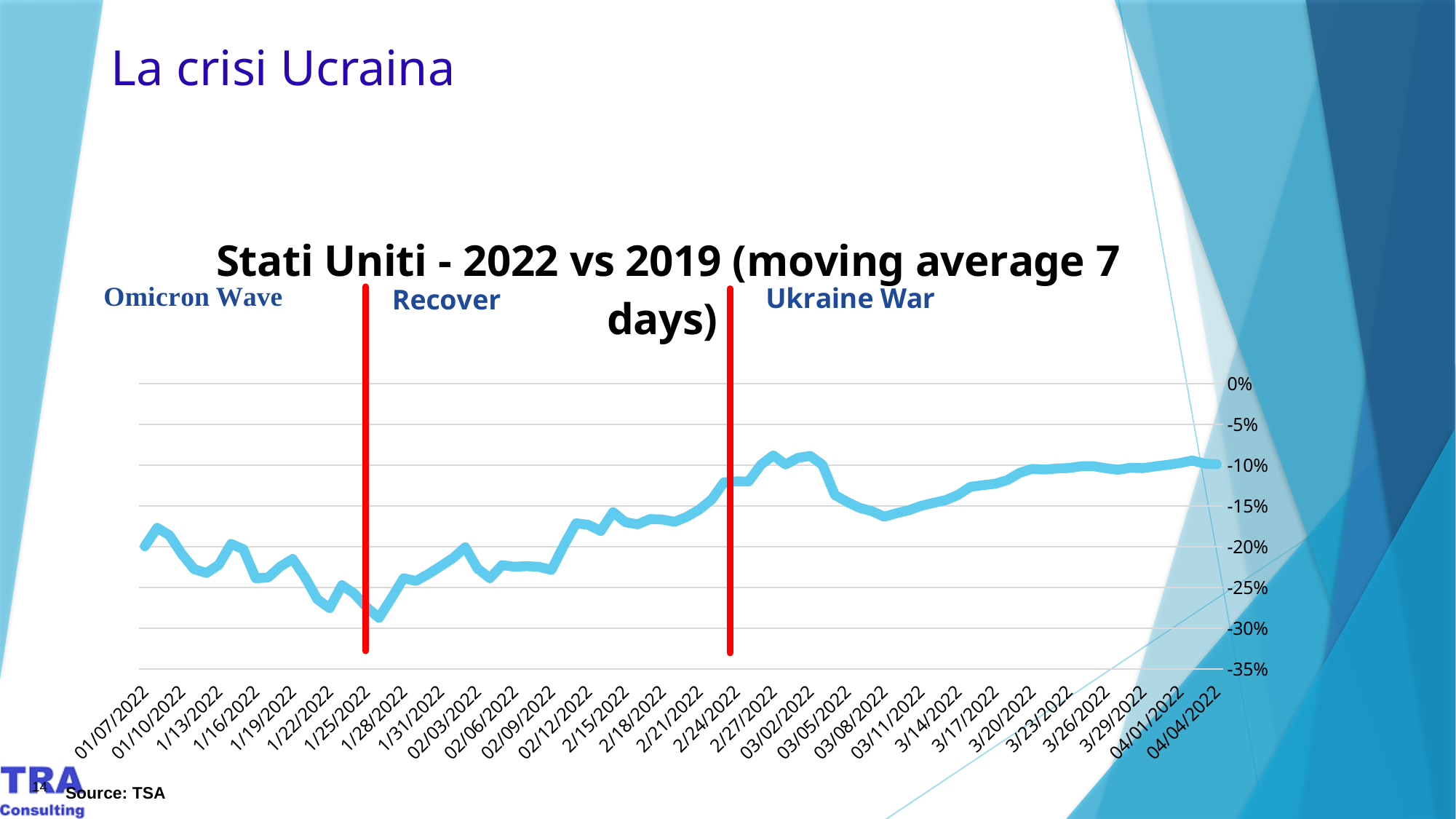
What is the title of the chart? Stati Uniti - 2022 vs 2019 (moving average 7 days) Which is larger, the value for 1/28/2022 or the value for 04/04/2022? 04/04/2022 What kind of chart is shown on the slide? line chart Does the line rise or fall from 03/08/2022 to 04/04/2022? rise Is the value for 2/12/2022 greater or less than -20%? greater What are the three period labels annotated above the chart, from left to right? Omicron Wave, Recover, Ukraine War Overall, does the line rise or fall from 01/07/2022 to 04/04/2022? rise Which is larger, the value for 01/07/2022 or the value for 2/27/2022? 2/27/2022 How many date labels are shown on the x axis? 30 Does the line rise or fall across the Omicron Wave period, from 01/07/2022 to 1/25/2022? fall Is the value for 03/08/2022 greater or less than -15%? less